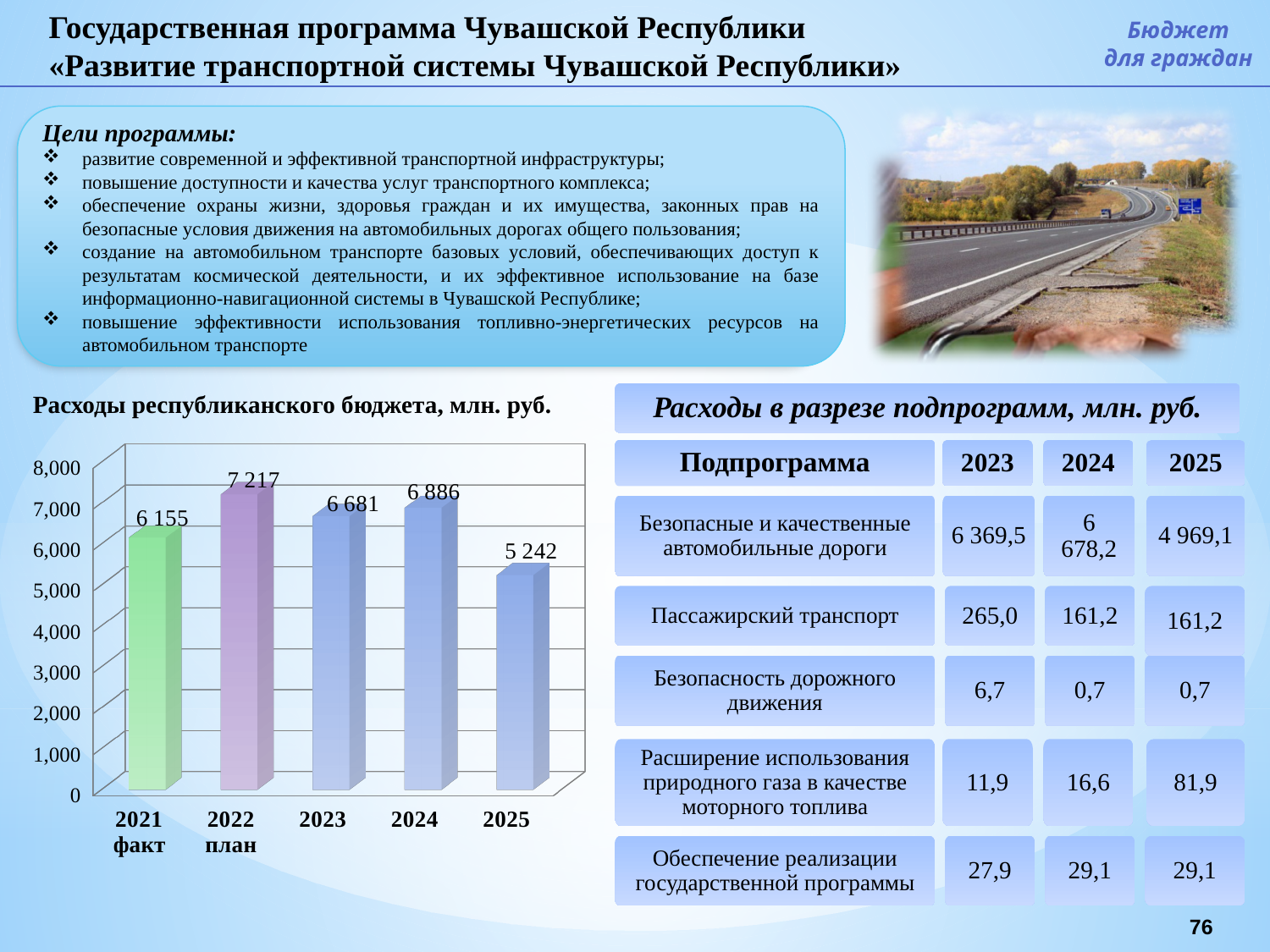
In the chart «Расходы республиканского бюджета, млн. руб.», what is the value for 2021 факт? 6 155 In the chart «Расходы республиканского бюджета, млн. руб.», what is the value for 2022 план? 7 217 What type of chart is shown under the heading «Расходы республиканского бюджета, млн. руб.»? bar chart In the chart «Расходы республиканского бюджета, млн. руб.», which year has the lowest value? 2025 In the chart «Расходы республиканского бюджета, млн. руб.», what is the value for 2025? 5 242 In the chart «Расходы республиканского бюджета, млн. руб.», what is the value for 2024? 6 886 In the chart «Расходы республиканского бюджета, млн. руб.», which year has the highest value? 2022 план How many bars are plotted in the chart «Расходы республиканского бюджета, млн. руб.»? 5 In the chart «Расходы республиканского бюджета, млн. руб.», what is the difference between the values for 2024 and 2023? 205 In the chart «Расходы республиканского бюджета, млн. руб.», is the value for 2025 greater or less than 6,000? less In the chart «Расходы республиканского бюджета, млн. руб.», which is larger: the value for 2021 факт or the value for 2023? 2023